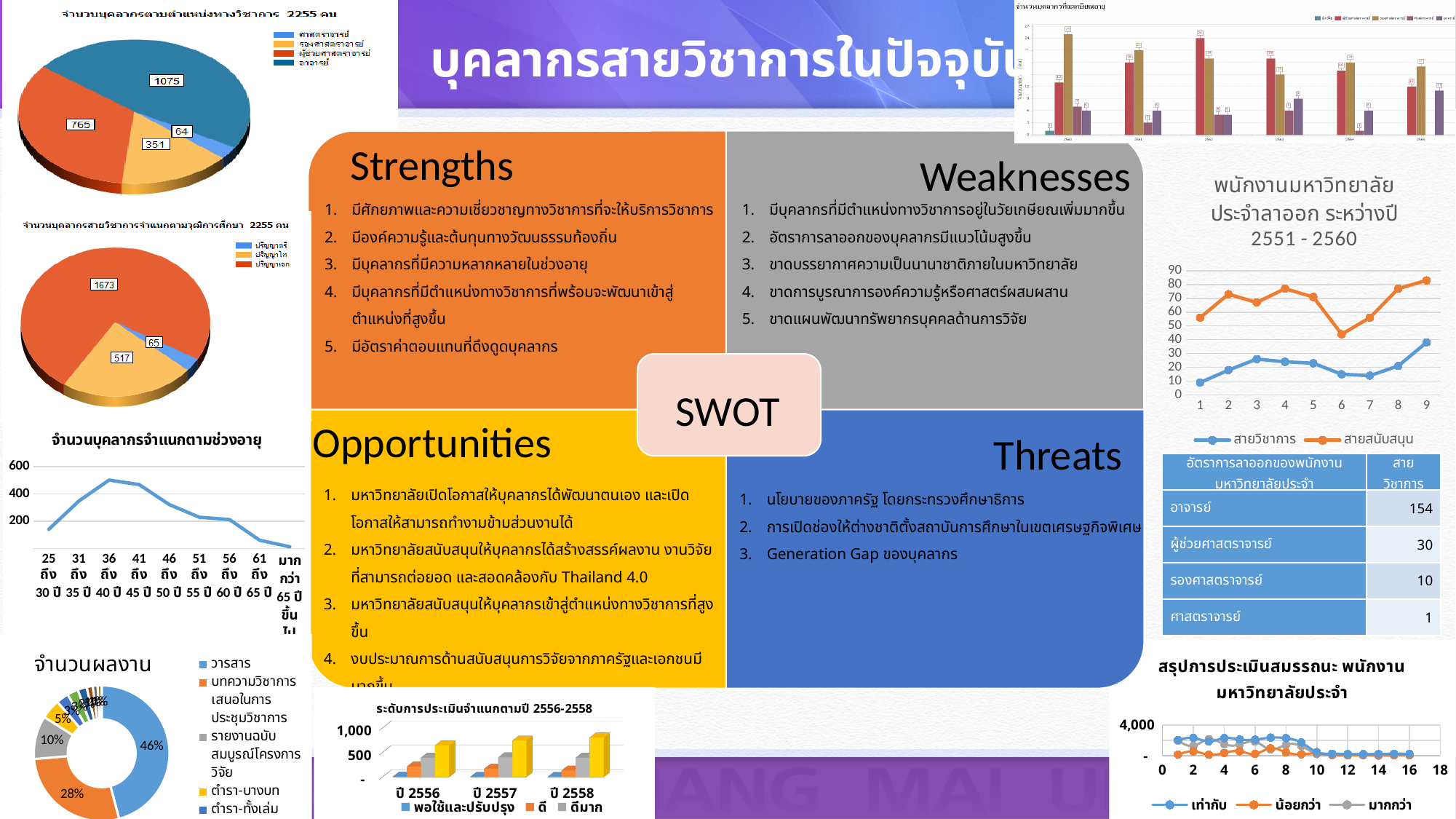
In the line chart titled 'จำนวนบุคลากรจำแนกตามช่วงอายุ' (left side), is the value for 25 ถึง 30 ปี greater or less than 200? less In the pie chart titled 'จำนวนบุคลากรสายวิชาการจำแนกตามวุฒิการศึกษา 2255 คน' (second from top on the left), which category has the largest value? ปริญญาเอก In the pie chart titled 'จำนวนบุคลากรตามตำแหน่งทางวิชาการ 2255 คน' (top left), which category has the smallest value? ศาสตราจารย์ In the chart titled 'พนักงานมหาวิทยาลัยประจำลาออก ระหว่างปี 2551 - 2560' (right side), which series is larger at point 9, สายวิชาการ or สายสนับสนุน? สายสนับสนุน In the line chart titled 'จำนวนบุคลากรจำแนกตามช่วงอายุ' (left side), which age group has the highest value? 36 ถึง 40 ปี In the donut chart titled 'จำนวนผลงาน' (bottom left), what share does วารสาร have? 46% In the pie chart titled 'จำนวนบุคลากรตามตำแหน่งทางวิชาการ 2255 คน' (top left), what is the difference between the values for ผู้ช่วยศาสตราจารย์ and รองศาสตราจารย์? 414 What kind of chart is 'ระดับการประเมินจำแนกตามปี 2556-2558' (bottom centre)? bar chart In the pie chart titled 'จำนวนบุคลากรตามตำแหน่งทางวิชาการ 2255 คน' (top left), what is the value for อาจารย์? 1075 In the chart titled 'พนักงานมหาวิทยาลัยประจำลาออก ระหว่างปี 2551 - 2560' (right side), how many series does the legend list? 2 In the pie chart titled 'จำนวนบุคลากรสายวิชาการจำแนกตามวุฒิการศึกษา 2255 คน', how many categories does the legend list? 3 In the pie chart titled 'จำนวนบุคลากรสายวิชาการจำแนกตามวุฒิการศึกษา 2255 คน' (second from top on the left), what is the value for ปริญญาโท? 517